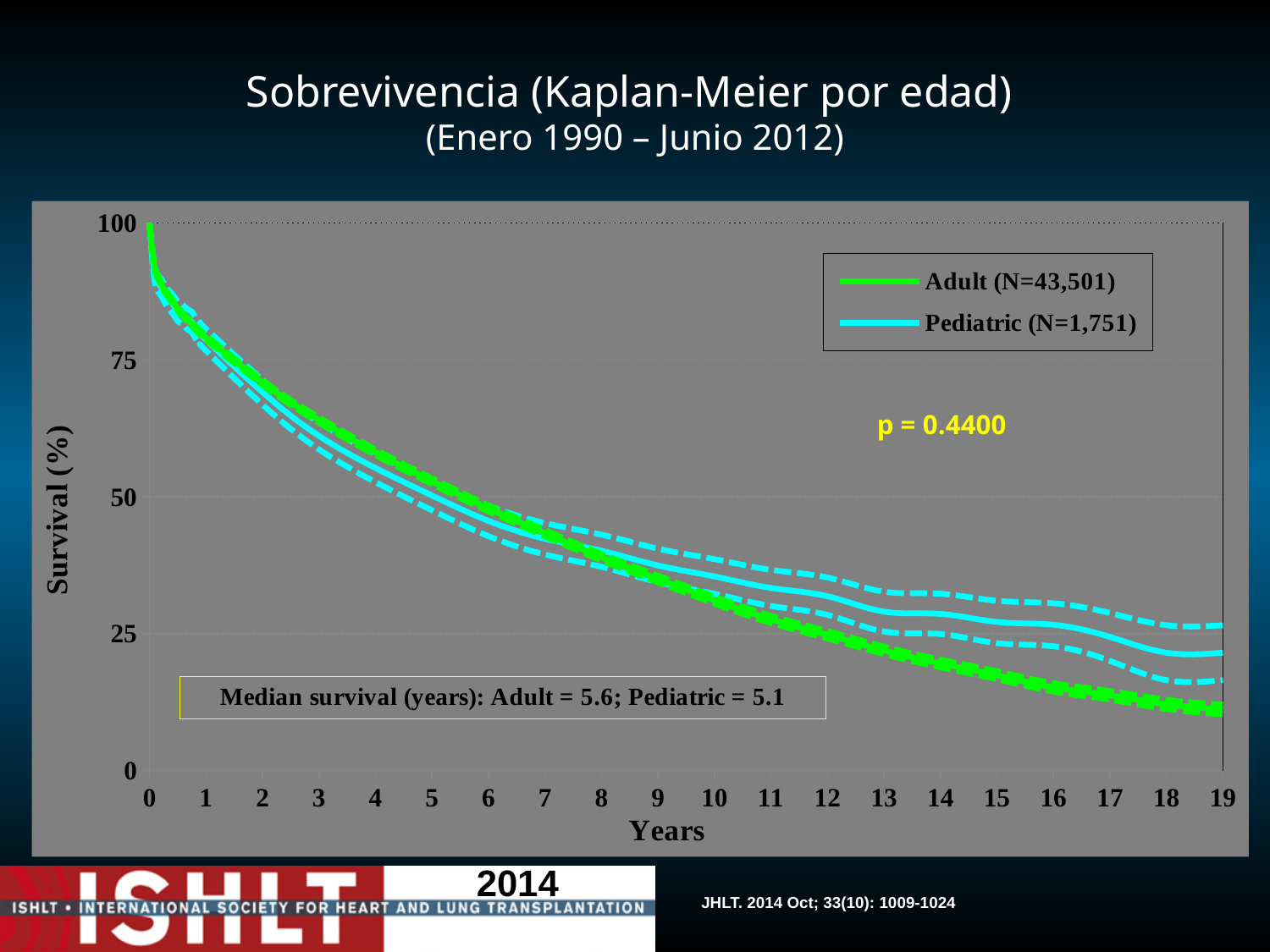
Do the survival curves rise or fall as the years increase? fall What p-value is shown on the chart? p = 0.4400 What is the difference in median survival (years) between the Adult and Pediatric groups? 0.5 What kind of chart is shown on the slide? line chart How many series does the legend list? 2 What is the median survival in years for the Adult group? 5.6 Which group has the longer median survival, Adult or Pediatric? Adult What is the N for the Adult group shown in the legend? 43,501 What is the median survival in years for the Pediatric group? 5.1 At 19 years, which curve shows higher survival, Adult or Pediatric? Pediatric Is the Adult survival value at 1 year greater or less than 75? greater Is the Adult survival value at 19 years greater or less than 25? less